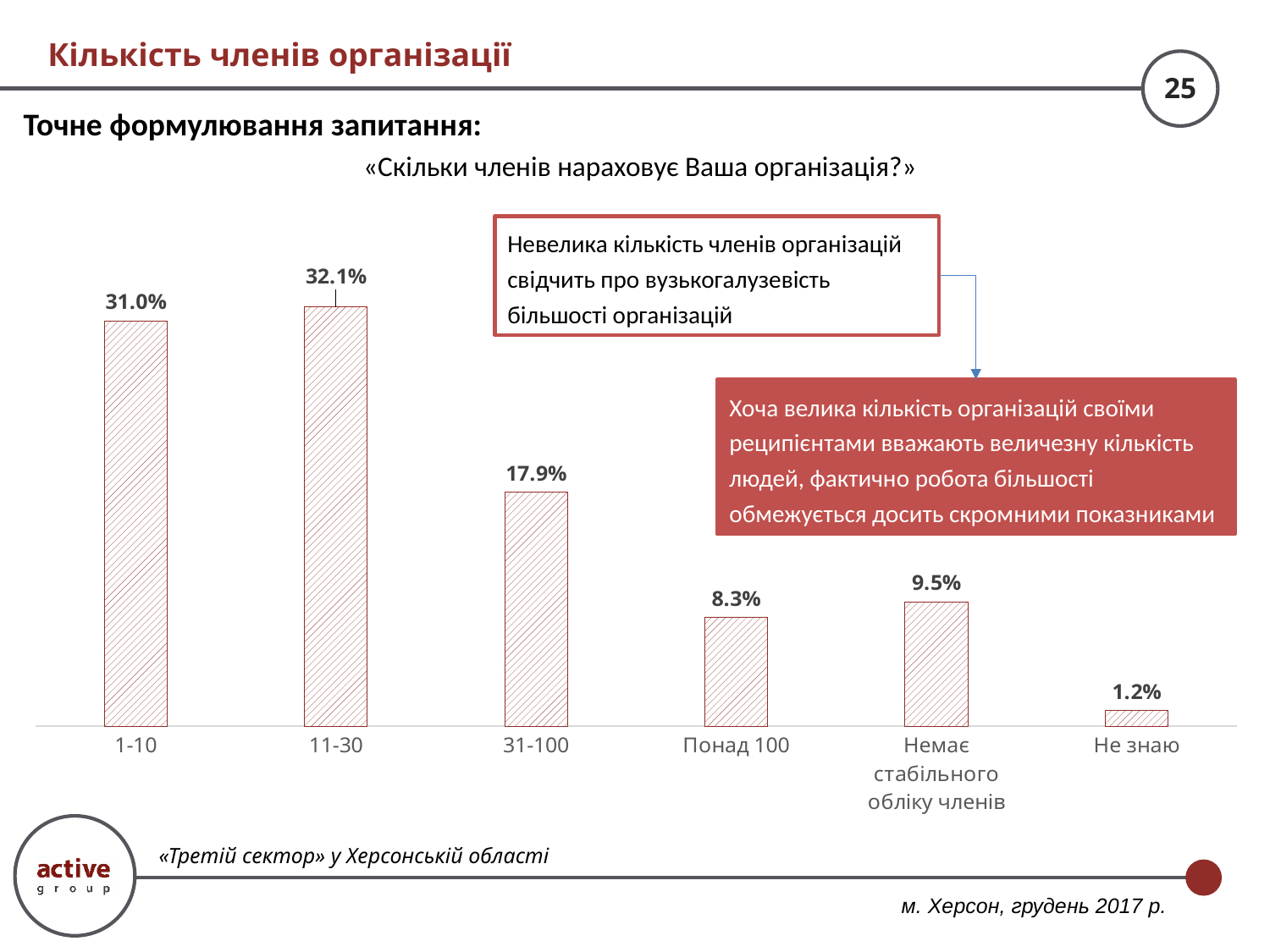
What kind of chart is shown on the slide? bar chart Which is larger: the value for "Понад 100" or the value for "Немає стабільного обліку членів"? Немає стабільного обліку членів How many categories are shown on the x axis of the chart? 6 What is the value for the category "1-10"? 31.0% Which category has the highest value? 11-30 What is the value for the category "Немає стабільного обліку членів"? 9.5% What is the difference between the values for "11-30" and "31-100"? 14.2% What is the survey question quoted above the chart? «Скільки членів нараховує Ваша організація?» What is the value for the category "31-100"? 17.9% Which category has the lowest value? Не знаю What is the value for the category "Понад 100"? 8.3% What is the value for the category "11-30"? 32.1%